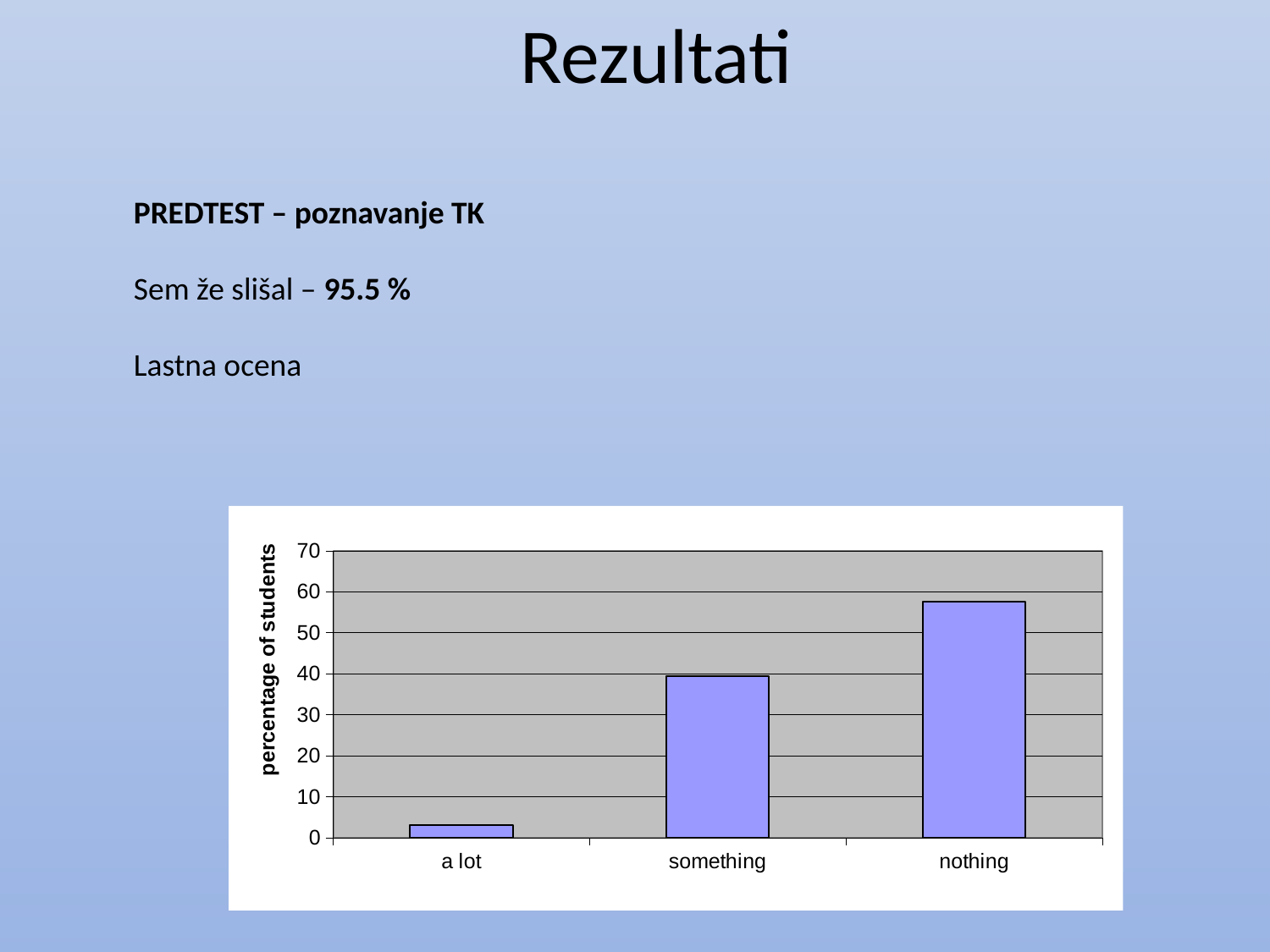
How many categories are shown on the x axis of the chart? 3 Is the value for "a lot" greater or less than 10? less What kind of chart is shown on the slide? bar chart Do the values rise or fall moving from "a lot" to "nothing" along the x axis? rise Which category has the highest percentage of students? nothing Which is larger, the value for "a lot" or the value for "something"? something Is the value for "nothing" greater or less than 60? less Which category has the lowest percentage of students? a lot What is the label of the vertical axis of the chart? percentage of students Is the value for "nothing" greater or less than 50? greater Which is larger, the value for "something" or the value for "nothing"? nothing